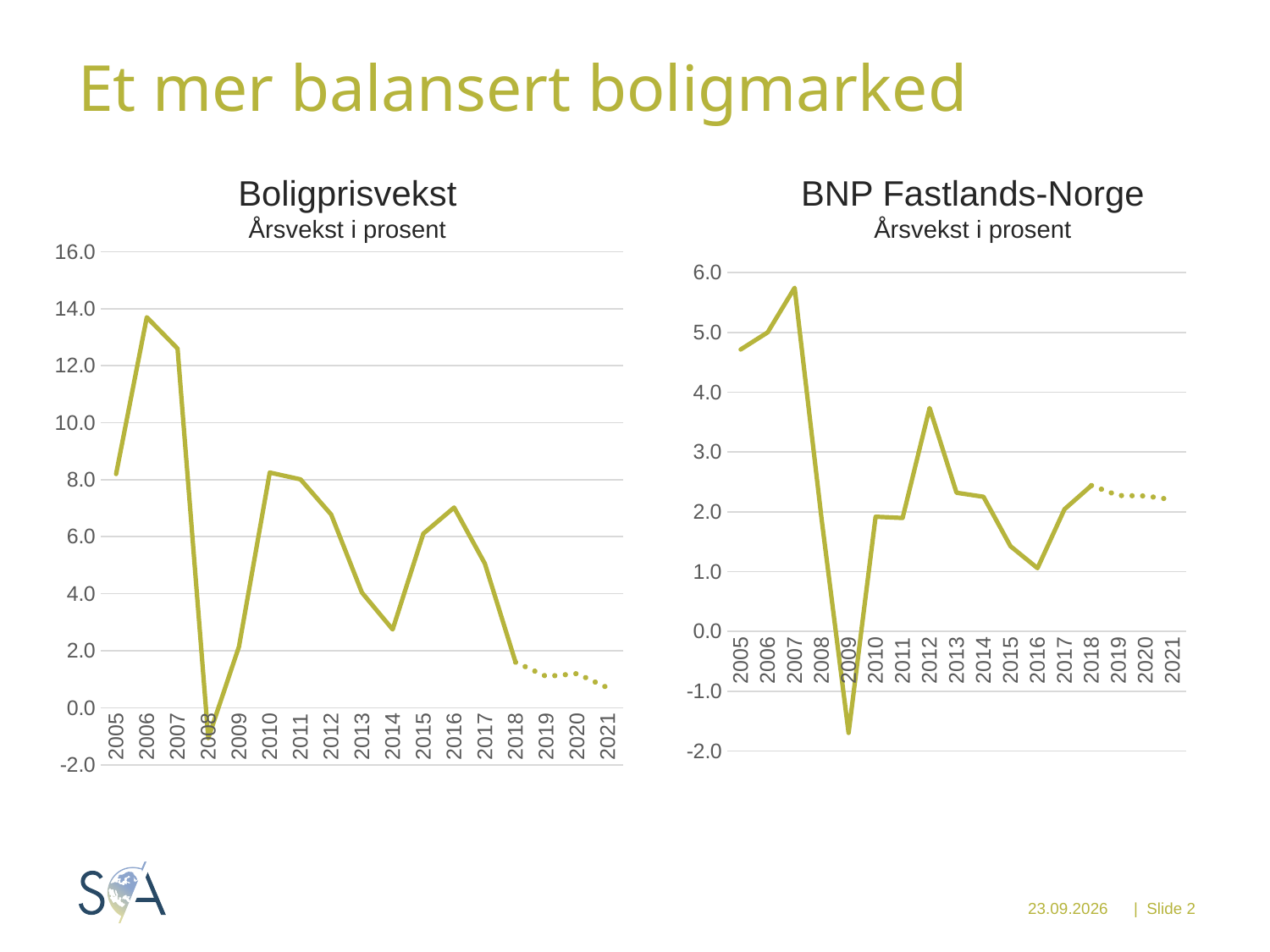
In the Boligprisvekst chart, is the value for 2014 greater or less than 4.0? less In the BNP Fastlands-Norge chart, which year has the highest value? 2007 In the BNP Fastlands-Norge chart, is the value for 2012 greater or less than 3.0? greater In the BNP Fastlands-Norge chart, is the value for 2016 greater or less than 2.0? less In the Boligprisvekst chart, is the value for 2006 larger or smaller than the value for 2016? larger In the Boligprisvekst chart, which year has the lowest value? 2008 In the BNP Fastlands-Norge chart, which year has the lowest value? 2009 How many years are shown on the x axis of the BNP Fastlands-Norge chart? 17 What kind of chart is the Boligprisvekst chart on the left? line chart In the Boligprisvekst chart, which year has the highest value? 2006 In the Boligprisvekst chart, do the values rise or fall from 2016 to 2018? fall